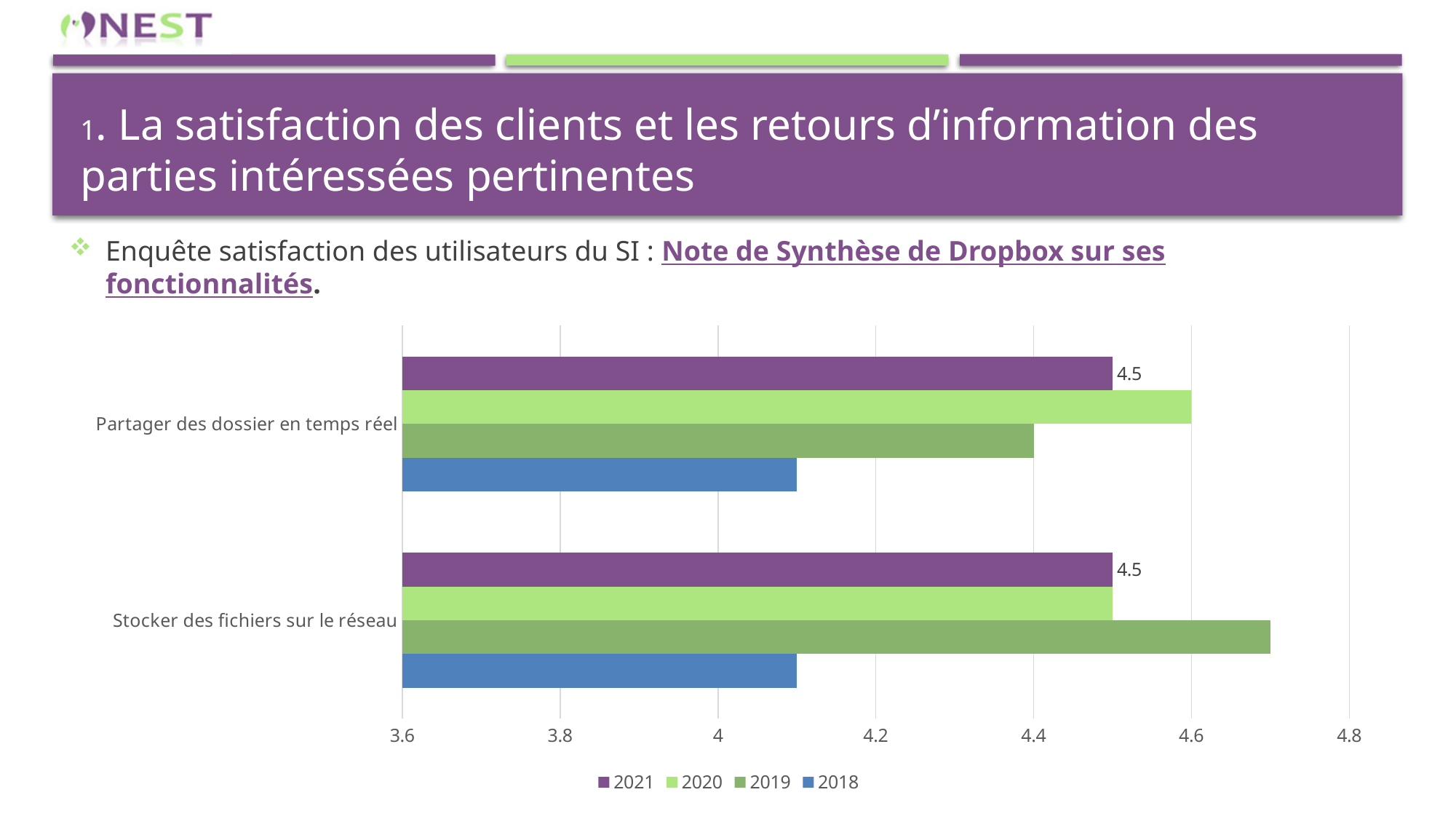
How many series does the legend list? 4 Is the value for 2019 for "Stocker des fichiers sur le réseau" greater or less than 4.6? greater Which year has the highest value for "Partager des dossier en temps réel"? 2020 Is the value for 2018 for "Partager des dossier en temps réel" greater or less than 4.2? less What is the difference between the 2020 and 2019 values for "Partager des dossier en temps réel"? 0.2 What is the value for 2020 for "Partager des dossier en temps réel"? 4.6 How many categories are shown on the chart? 2 What is the value for 2019 for "Partager des dossier en temps réel"? 4.4 What kind of chart is shown on the slide? bar chart What is the value for 2021 for "Stocker des fichiers sur le réseau"? 4.5 Which year has the lowest value for "Stocker des fichiers sur le réseau"? 2018 What is the value for 2021 for "Partager des dossier en temps réel"? 4.5